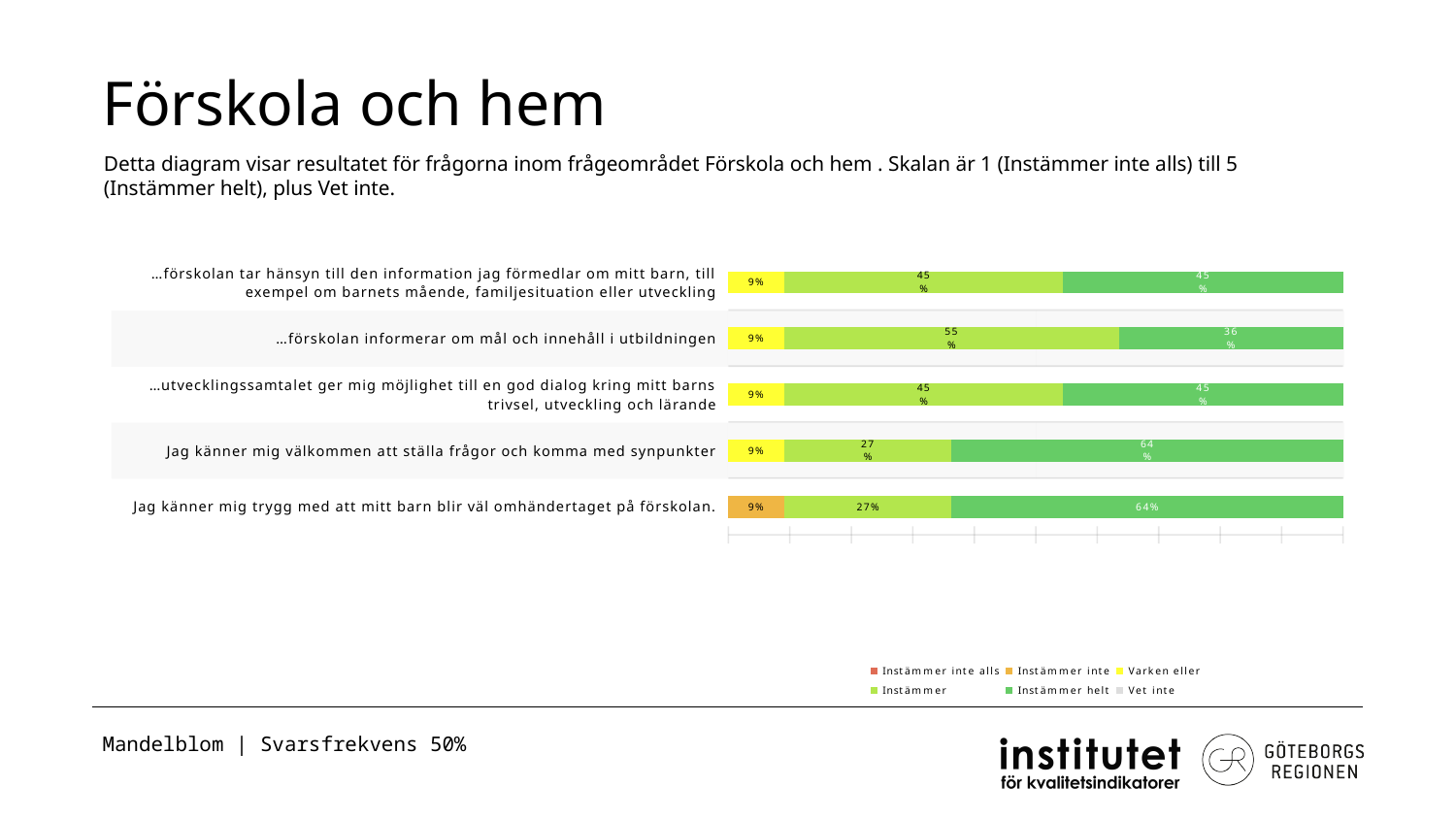
What is the title of the slide containing the chart? Förskola och hem What is the value of the dark green (Instämmer helt) segment for "Jag känner mig trygg med att mitt barn blir väl omhändertaget på förskolan"? 64% Which is larger: the Instämmer helt value for "…utvecklingssamtalet ger mig möjlighet till en god dialog kring mitt barns trivsel, utveckling och lärande" or for "…förskolan informerar om mål och innehåll i utbildningen"? …utvecklingssamtalet ger mig möjlighet till en god dialog kring mitt barns trivsel, utveckling och lärande Which statement has the highest value for the light green (Instämmer) segment? …förskolan informerar om mål och innehåll i utbildningen What is the difference between the Instämmer helt value for "Jag känner mig välkommen att ställa frågor och komma med synpunkter" (64%) and for "…förskolan informerar om mål och innehåll i utbildningen" (36%)? 28 percentage points How many categories (statements) are plotted in the chart? 5 Which statement has the lowest value for the dark green (Instämmer helt) segment? …förskolan informerar om mål och innehåll i utbildningen What is the value of the leftmost (orange) segment for "Jag känner mig välkommen att ställa frågor och komma med synpunkter"? 9% What is the total of the labelled segments (9%, 55%, 36%) in the bar for "…förskolan informerar om mål och innehåll i utbildningen"? 100% What is the value of the light green (Instämmer) segment for "…förskolan informerar om mål och innehåll i utbildningen"? 55% What kind of chart is shown on the slide? Stacked bar chart How many series does the legend list? 6